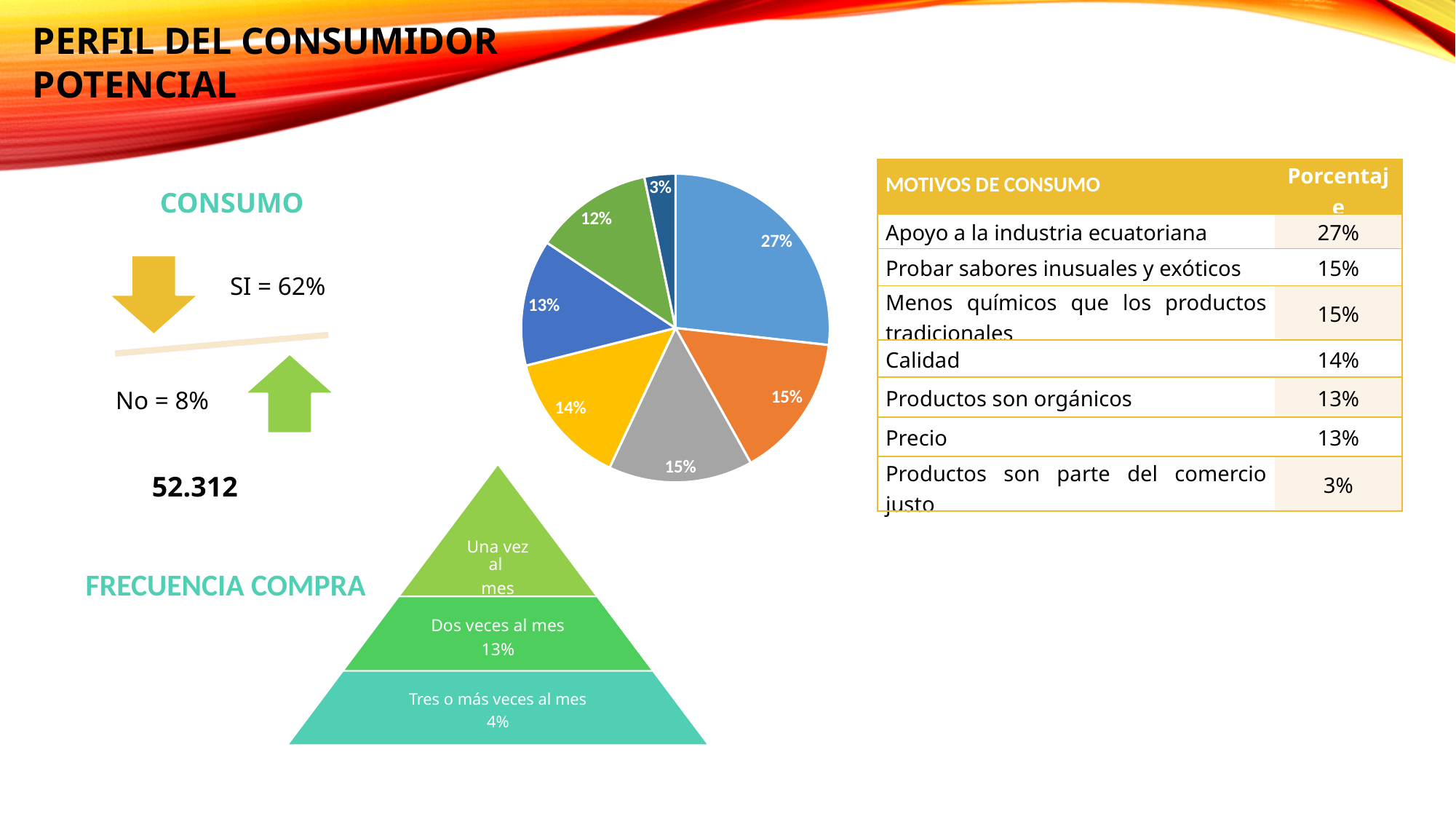
What is the value of the smallest slice in the pie chart? 3% How many slices does the pie chart have? 7 What is the value of the largest slice in the pie chart? 27% What share of the pie chart does the light blue slice represent? 27% In the pie chart, which is larger: the light blue slice or the orange slice? the light blue slice Does the pie chart display a legend? No What is the difference between the largest and smallest slices in the pie chart? 24 percentage points What kind of chart is shown in the middle of the slide? pie chart In the pie chart, what is the value of the dark blue slice at the top? 3% In the pie chart, what is the value of the green slice? 12% In the pie chart, what is the value of the gray slice? 15% In the pie chart, what is the value of the yellow slice? 14%